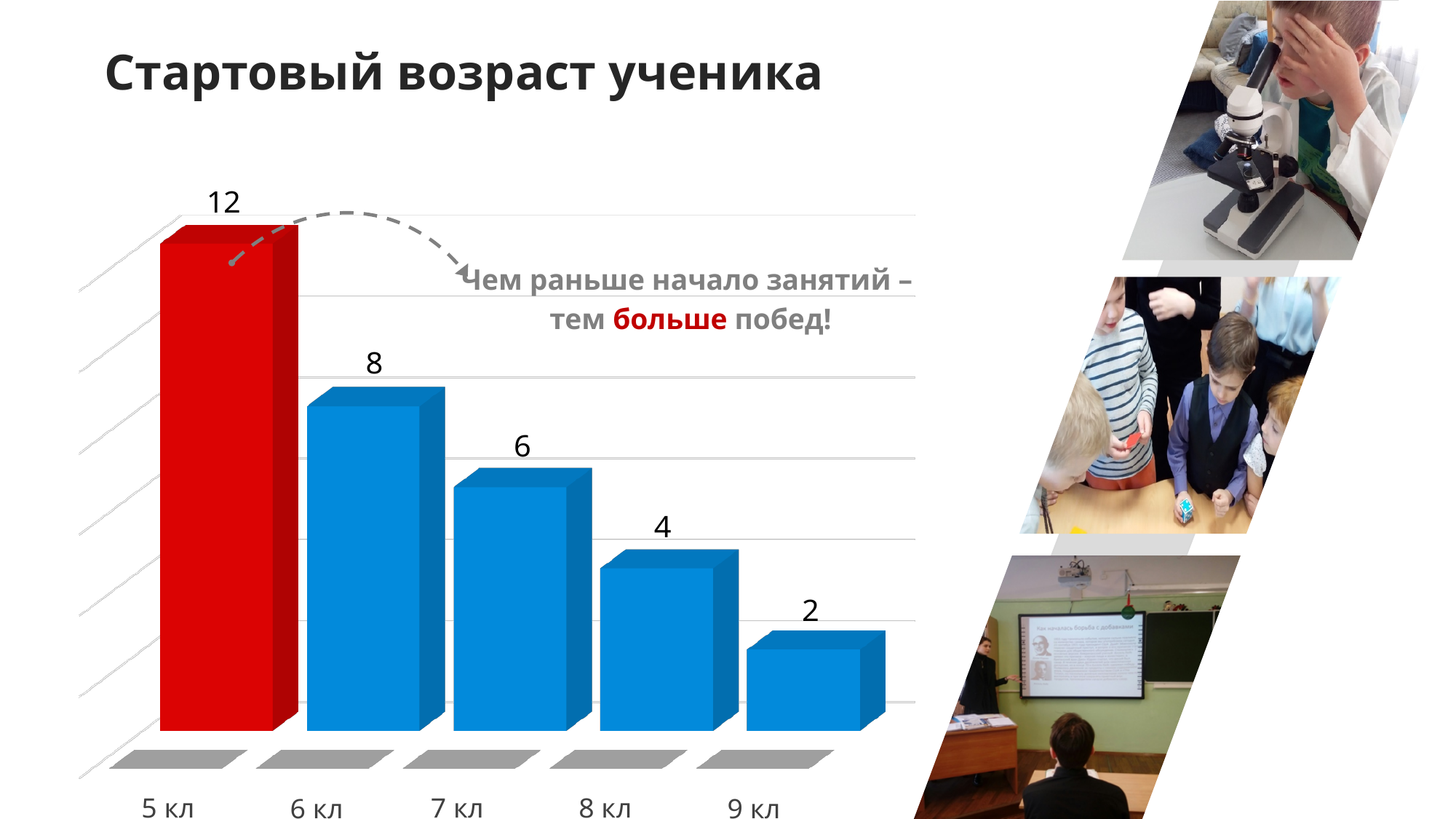
What is the value for 9 кл? 2 What is the difference between the values for 8 кл and 9 кл? 2 What is the value for 5 кл? 12 What is the value for 7 кл? 6 What kind of chart is shown on the slide? bar chart Which bar is coloured red? 5 кл Which category has the highest value? 5 кл What is the difference between the values for 5 кл and 6 кл? 4 Which category has the lowest value? 9 кл How many categories are shown on the x axis? 5 Which is larger, the value for 6 кл or the value for 8 кл? 6 кл Do the values rise or fall from 5 кл to 9 кл? fall